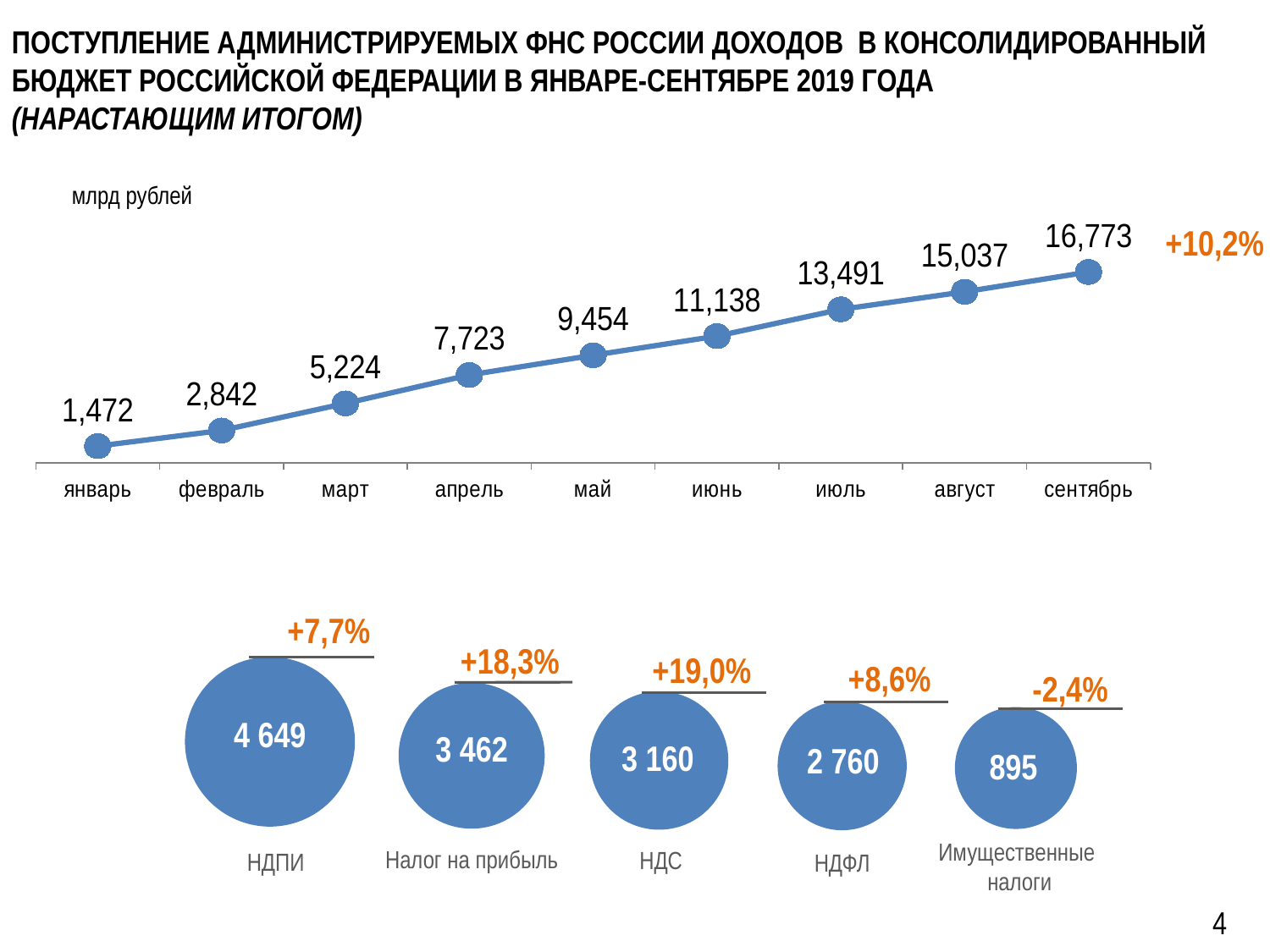
On the bottom bubble chart, what is the value for НДС? 3 160 On the top line chart, what is the value for май? 9,454 On the bottom bubble chart, what is the difference between the values for НДПИ and НДС? 1 489 On the top line chart, what growth percentage is shown next to the сентябрь point? +10,2% On the bottom bubble chart, which category has the highest value? НДПИ On the top line chart, do the values rise or fall from январь to сентябрь? rise On the top line chart, what is the difference between the values for сентябрь and август? 1,736 On the top line chart, what is the value for сентябрь? 16,773 On the bottom bubble chart, what percentage change is shown for Налог на прибыль? +18,3% What type of chart is the top chart on the slide? line chart On the top line chart, how many months are plotted? 9 On the top line chart, which month has the lowest value? январь